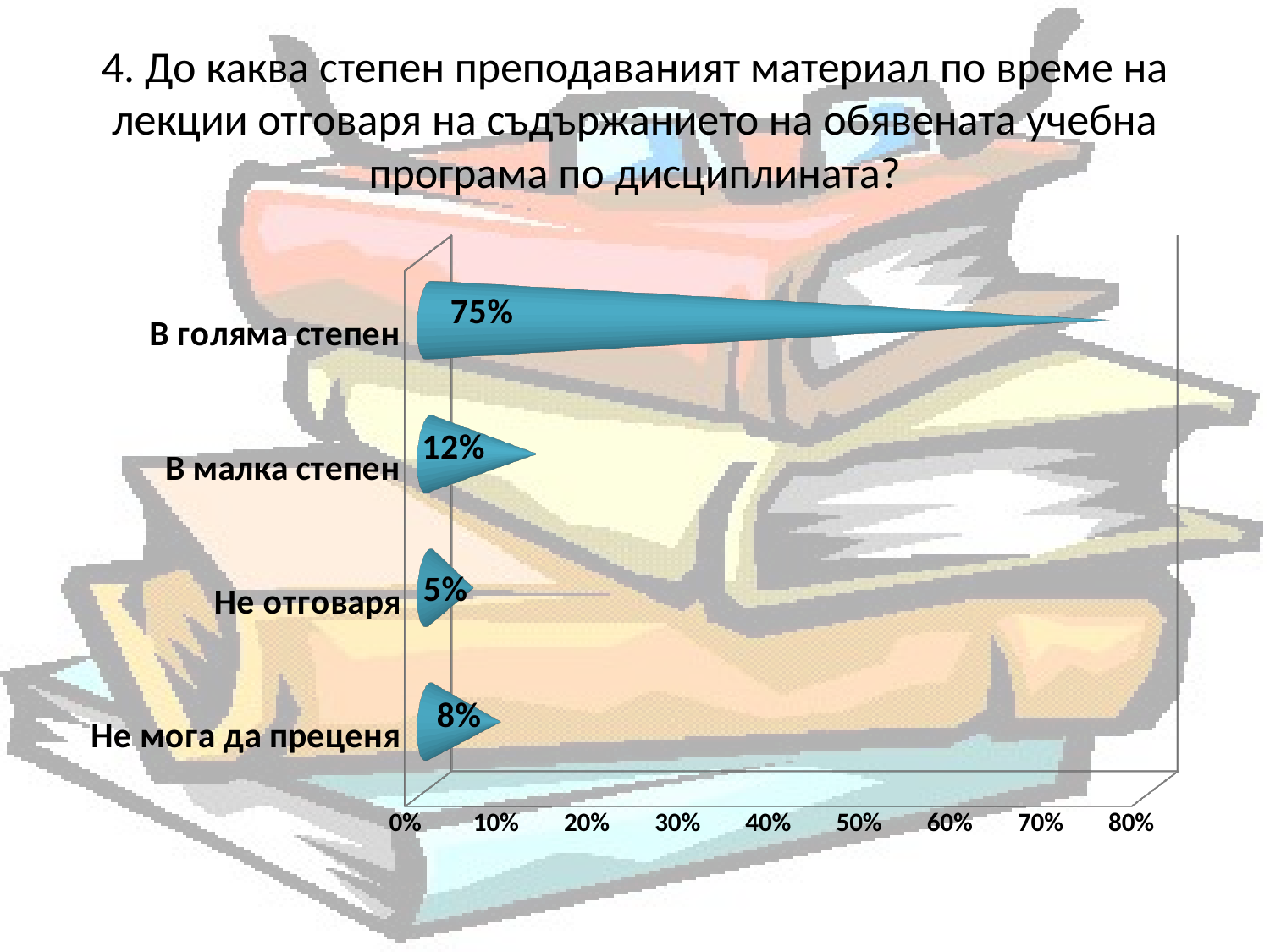
What is the value for "В малка степен"? 12% Is the value for "В голяма степен" greater or less than 70%? greater What is the value for "Не отговаря"? 5% Which category has the lowest value? Не отговаря What is the maximum value shown on the horizontal axis? 80% What is the value for "В голяма степен"? 75% Which is larger, the value for "Не мога да преценя" or the value for "Не отговаря"? Не мога да преценя How many categories are shown in the chart? 4 Which category has the highest value? В голяма степен What is the difference between the values for "В голяма степен" and "В малка степен"? 63% What is the value for "Не мога да преценя"? 8% What kind of chart is shown on the slide? bar chart